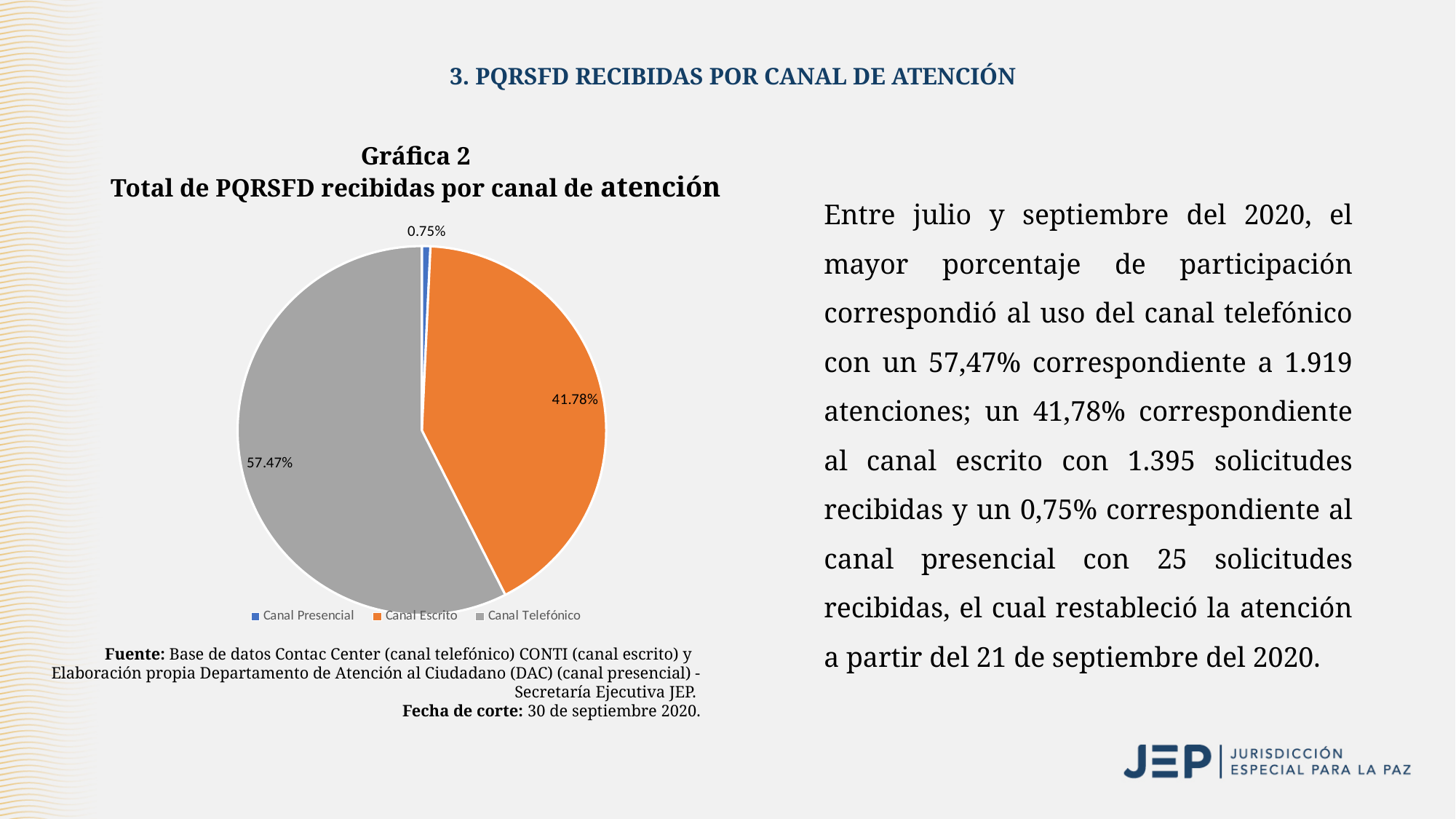
What is the title of the chart? Gráfica 2 Total de PQRSFD recibidas por canal de atención Which channel has the smallest slice of the pie? Canal Presencial Which is larger, the share for Canal Escrito or the share for Canal Presencial? Canal Escrito How many slices does the pie chart have? 3 Which channel has the largest slice of the pie? Canal Telefónico What kind of chart is shown on the slide? Pie chart What share of the pie does Canal Escrito represent? 41.78% What share of the pie does Canal Presencial represent? 0.75% What is the difference in percentage points between Canal Telefónico and Canal Escrito? 15.69 What colour is the Canal Escrito slice? Orange What share of the pie does Canal Telefónico represent? 57.47% How many entries does the legend list? 3